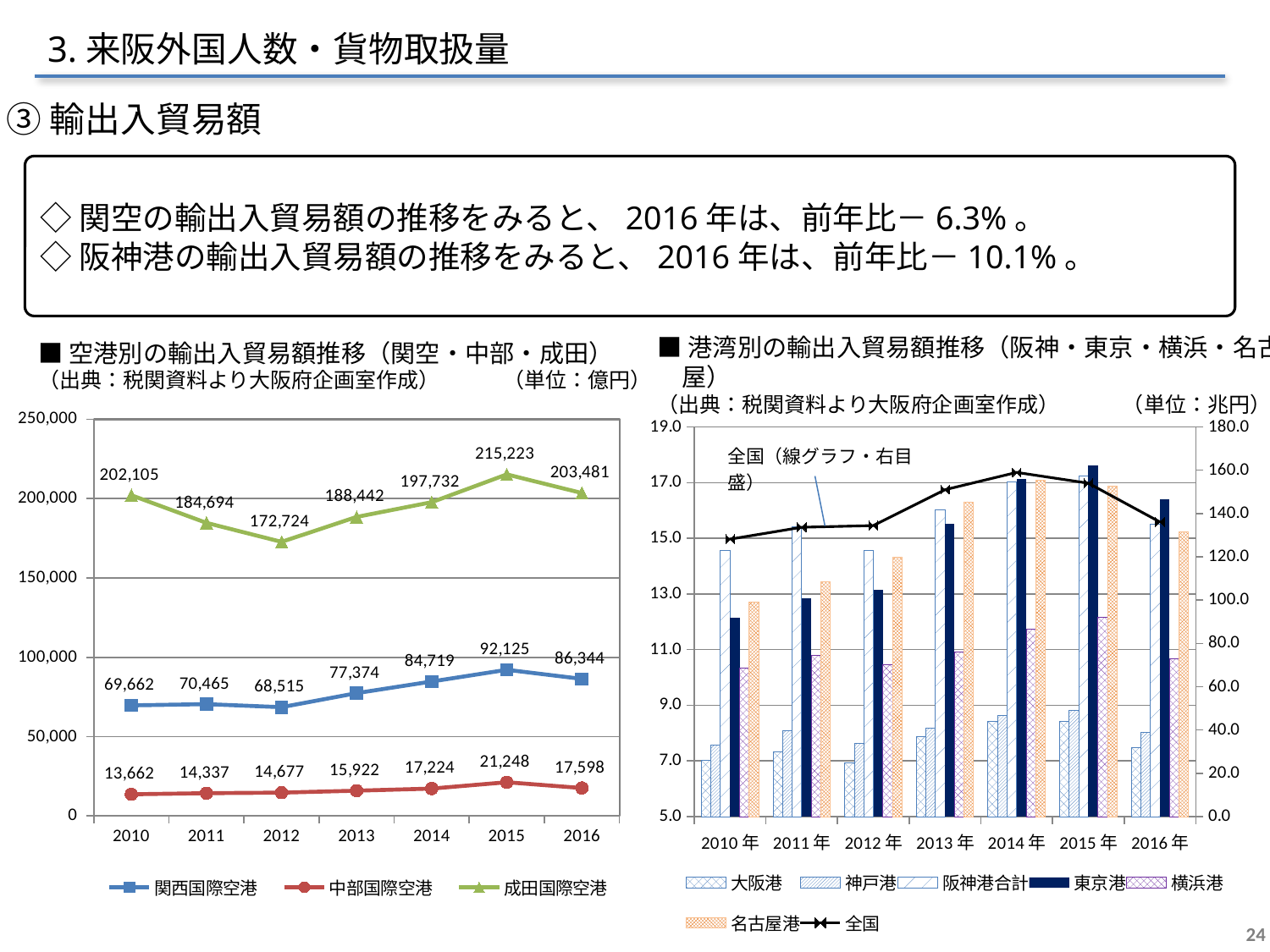
In the right chart (港湾別の輸出入貿易額推移), is the value for 東京港 in 2016 年 greater or less than 15.0? greater In the left chart (空港別の輸出入貿易額推移), in which year is the value for 中部国際空港 highest? 2015 In the left chart (空港別の輸出入貿易額推移), what kind of chart is it? Line chart In the right chart (港湾別の輸出入貿易額推移), which series is plotted as a line on the right axis? 全国 In the left chart (空港別の輸出入貿易額推移), does the value for 関西国際空港 rise or fall from 2012 to 2015? Rise In the left chart (空港別の輸出入貿易額推移), what is the value for 成田国際空港 in 2012? 172,724 In the left chart (空港別の輸出入貿易額推移), what is the value for 関西国際空港 in 2016? 86,344 In the right chart (港湾別の輸出入貿易額推移), how many series does the legend list? 7 In the left chart (空港別の輸出入貿易額推移), which is larger: the 2013 value for 成田国際空港 or the 2014 value for 成田国際空港? 2014 In the left chart (空港別の輸出入貿易額推移), what is the difference between the 2015 and 2016 values for 関西国際空港? 5,781 In the left chart (空港別の輸出入貿易額推移), how many series does the legend list? 3 In the left chart (空港別の輸出入貿易額推移), in which year is the value for 関西国際空港 lowest? 2012